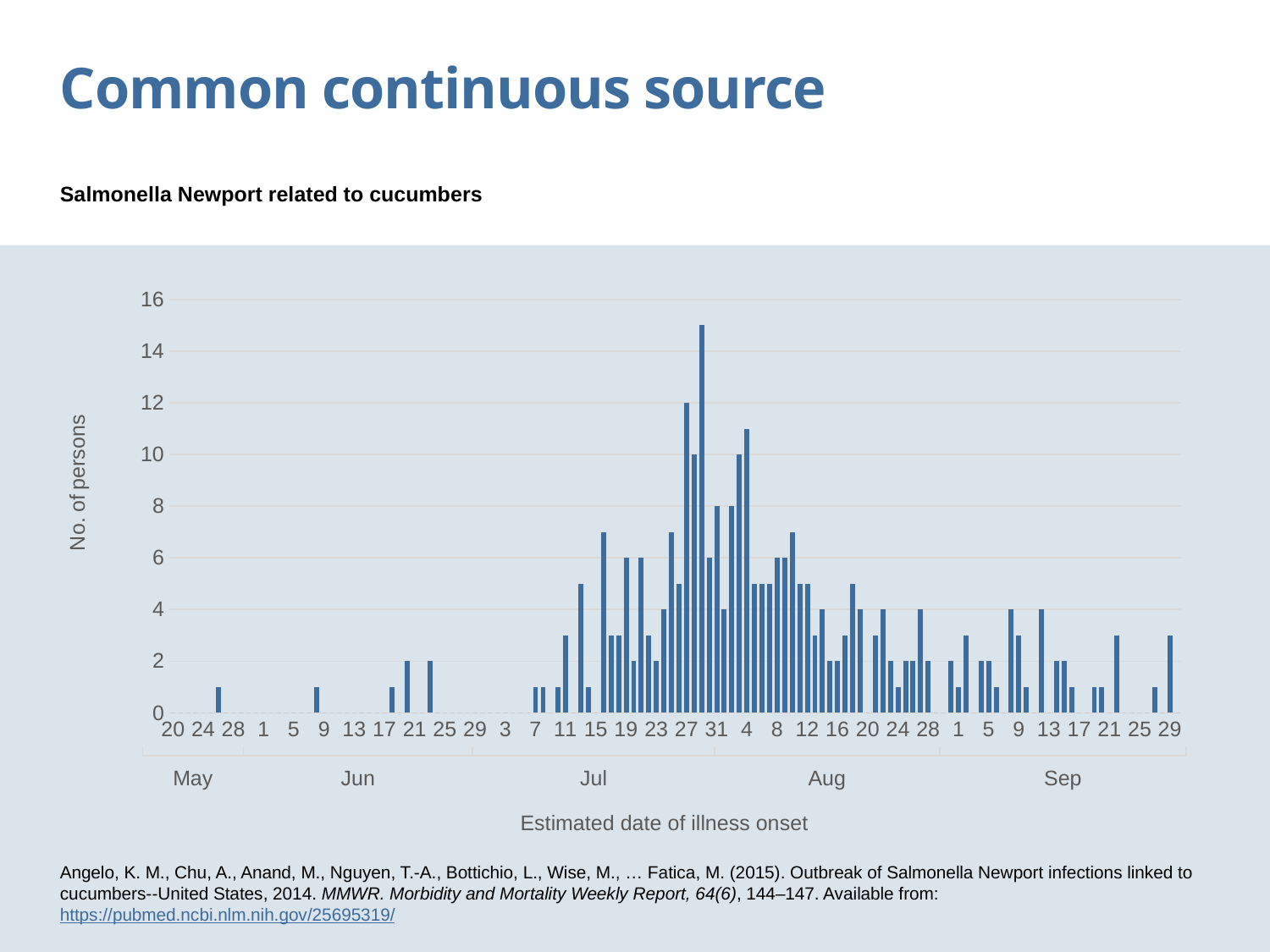
What is the label of the x axis? Estimated date of illness onset Is the highest bar in September greater or less than 6? less Do the values generally rise or fall from early August to late September? fall Which month has the lowest peak number of persons? May In which month does the tallest bar on the chart occur? Jul How many months are labelled along the x axis? 5 Is the peak in July larger or smaller than the peak in June? larger What is the label of the y axis? No. of persons Is the highest bar in May greater or less than 2? less What kind of chart is shown on the slide? bar chart Is the tallest bar on the chart greater or less than 14? greater Do the values generally rise or fall from early July to late July? rise